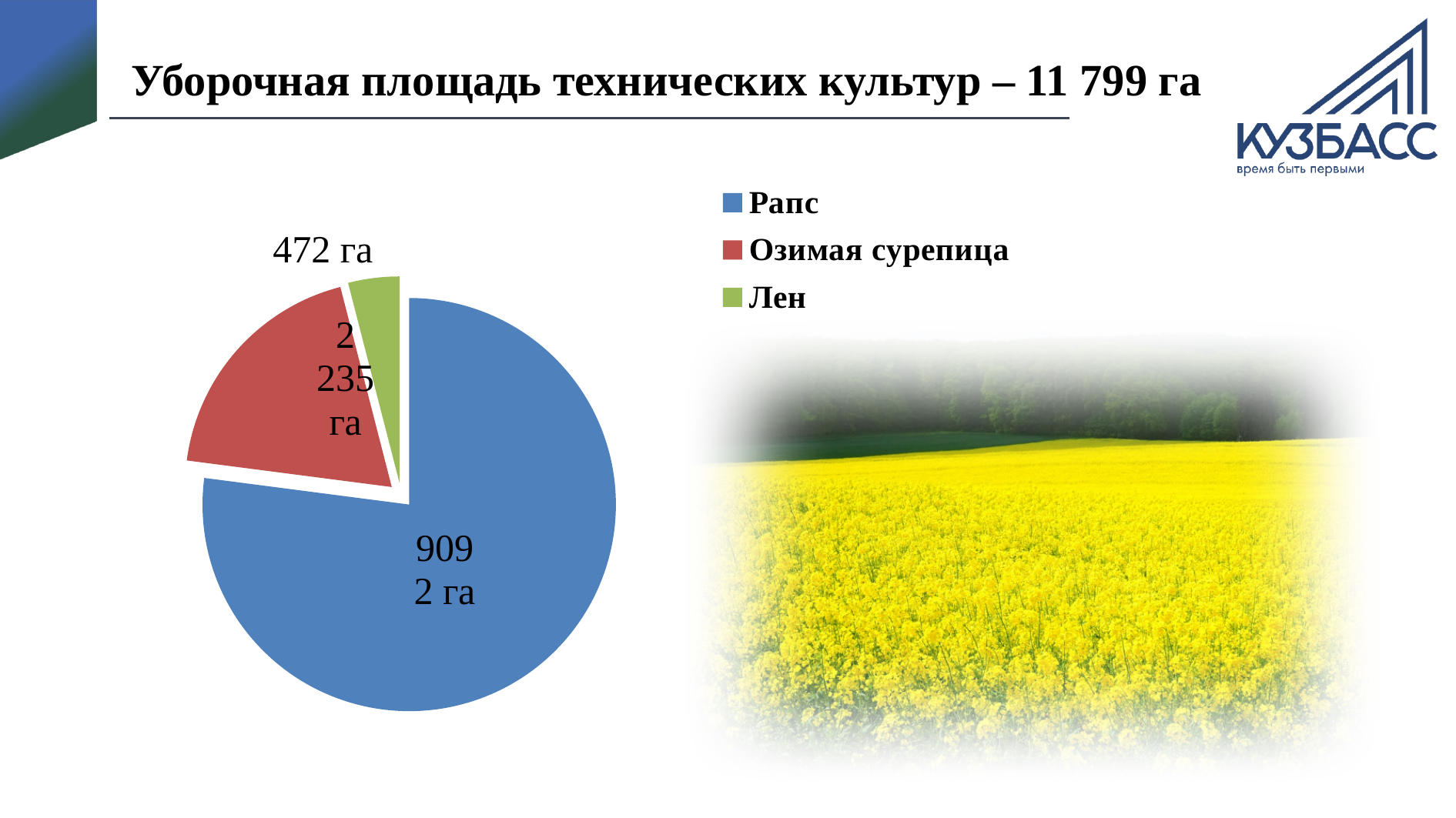
What is the difference between the values for Рапс and Озимая сурепица? 6857 га What is the value shown for Озимая сурепица? 2 235 га Which category has the smallest slice of the pie? Лен What is the value shown for Лен? 472 га What is the value shown for Рапс? 9092 га Which is larger, Озимая сурепица or Лен? Озимая сурепица Which category has the largest slice of the pie? Рапс What kind of chart is shown on the slide? pie chart Which colour represents Лен in the pie chart? green How many slices does the pie chart have? 3 What is the total harvested area given in the slide title? 11 799 га How many entries does the legend list? 3